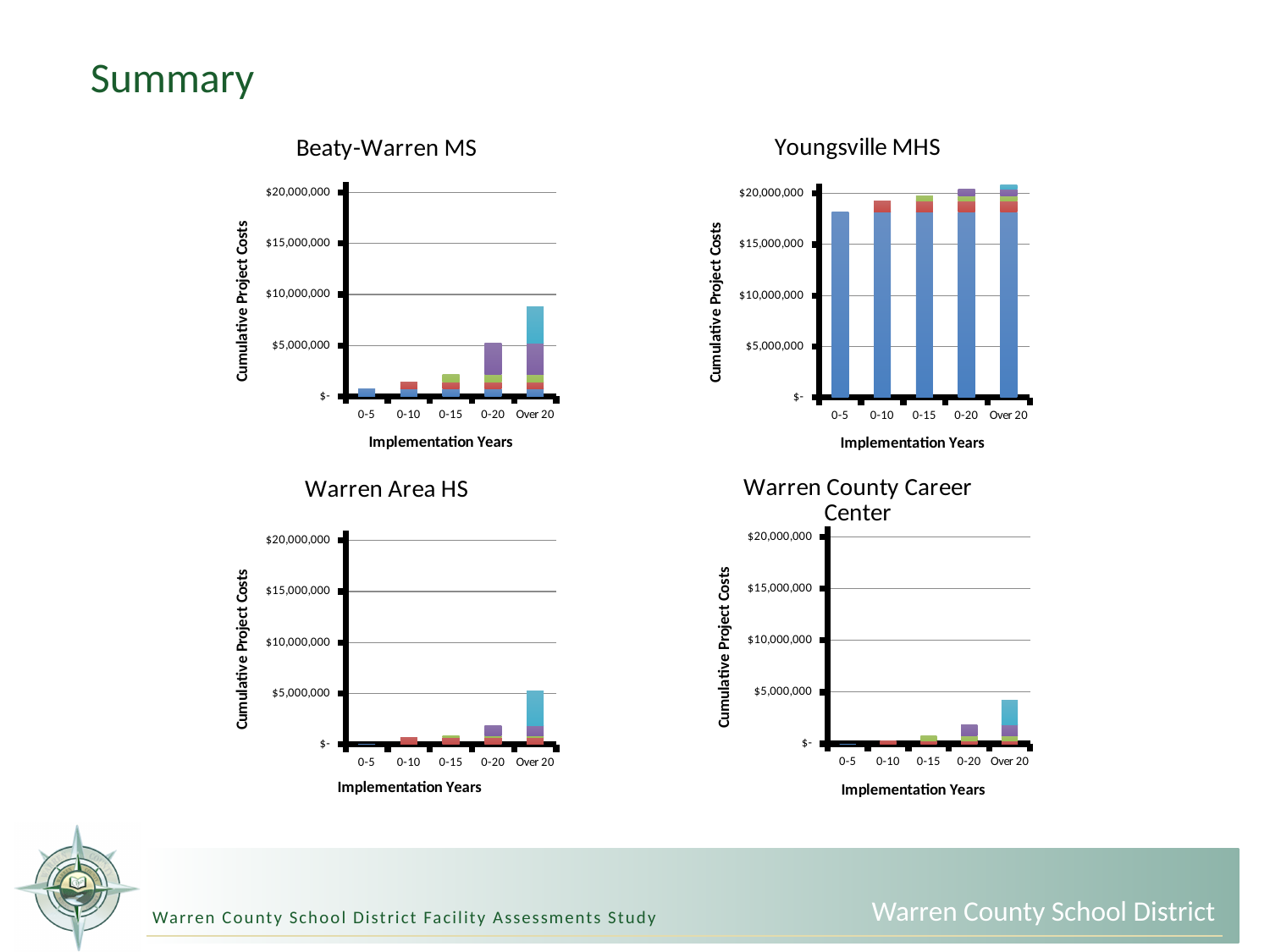
In the Beaty-Warren MS chart, which implementation-year category has the highest cumulative project cost? Over 20 Which is larger: the Over 20 cumulative project cost in the Beaty-Warren MS chart or in the Warren Area HS chart? Beaty-Warren MS In the Warren County Career Center chart, is the cumulative project cost for Over 20 greater or less than $5,000,000? less In the Youngsville MHS chart, do the cumulative project costs rise or fall from 0-5 to Over 20? rise How many implementation-year categories are shown on the x axis of the Beaty-Warren MS chart? 5 In the Beaty-Warren MS chart, is the cumulative project cost for Over 20 greater or less than $5,000,000? greater What kind of chart is the Beaty-Warren MS chart? Stacked bar chart What is the y-axis label on the Warren Area HS chart? Cumulative Project Costs In the Youngsville MHS chart, which implementation-year category has the lowest cumulative project cost? 0-5 In the Warren Area HS chart, is the cumulative project cost for Over 20 greater or less than $10,000,000? less In the Warren County Career Center chart, which implementation-year category has the highest cumulative project cost? Over 20